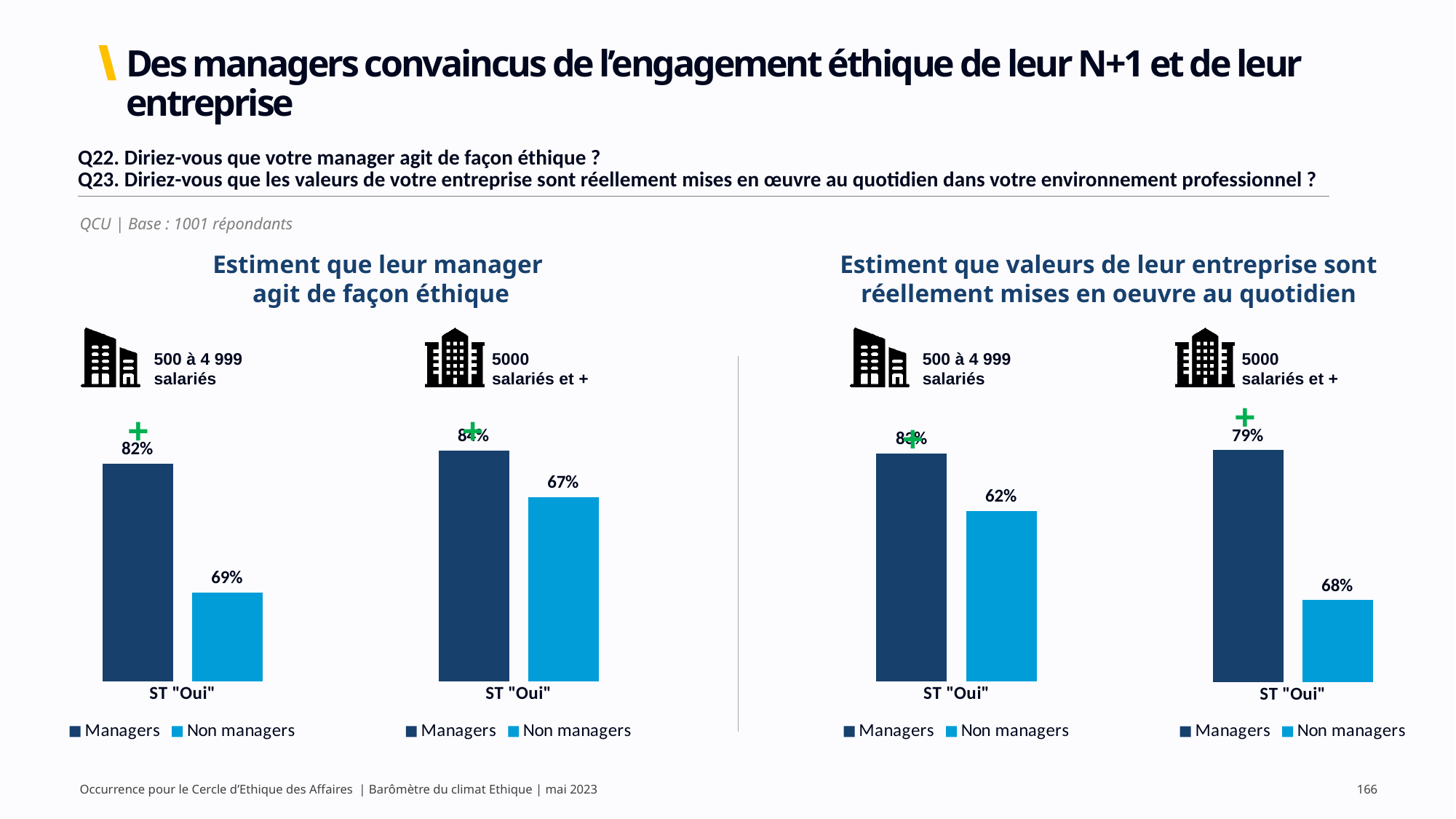
What kind of chart is used for 'Estiment que valeurs de leur entreprise sont réellement mises en oeuvre au quotidien' for companies with 5000 salariés et +? Bar chart In the chart 'Estiment que valeurs de leur entreprise sont réellement mises en oeuvre au quotidien' for companies with 5000 salariés et +, what is the value for Managers? 79% In the chart 'Estiment que valeurs de leur entreprise sont réellement mises en oeuvre au quotidien' for companies with 500 à 4 999 salariés, which is larger, Managers or Non managers? Managers In the chart 'Estiment que leur manager agit de façon éthique' for companies with 5000 salariés et +, which series has the lower value? Non managers How many series does the legend list for the chart 'Estiment que leur manager agit de façon éthique' for companies with 500 à 4 999 salariés? 2 In the chart 'Estiment que leur manager agit de façon éthique' for companies with 500 à 4 999 salariés, what is the difference between Managers and Non managers? 13 percentage points In the chart 'Estiment que valeurs de leur entreprise sont réellement mises en oeuvre au quotidien' for companies with 5000 salariés et +, what is the value for Non managers? 68% In the chart 'Estiment que leur manager agit de façon éthique' for companies with 500 à 4 999 salariés, what is the value for Non managers? 69% In the chart 'Estiment que valeurs de leur entreprise sont réellement mises en oeuvre au quotidien' for companies with 500 à 4 999 salariés, what is the value for Non managers? 62% In the chart 'Estiment que leur manager agit de façon éthique' for companies with 5000 salariés et +, what is the value for Non managers? 67% In the chart 'Estiment que valeurs de leur entreprise sont réellement mises en oeuvre au quotidien' for companies with 5000 salariés et +, what is the difference between Managers and Non managers? 11 percentage points In the chart 'Estiment que leur manager agit de façon éthique' for companies with 500 à 4 999 salariés, what is the value for Managers? 82%